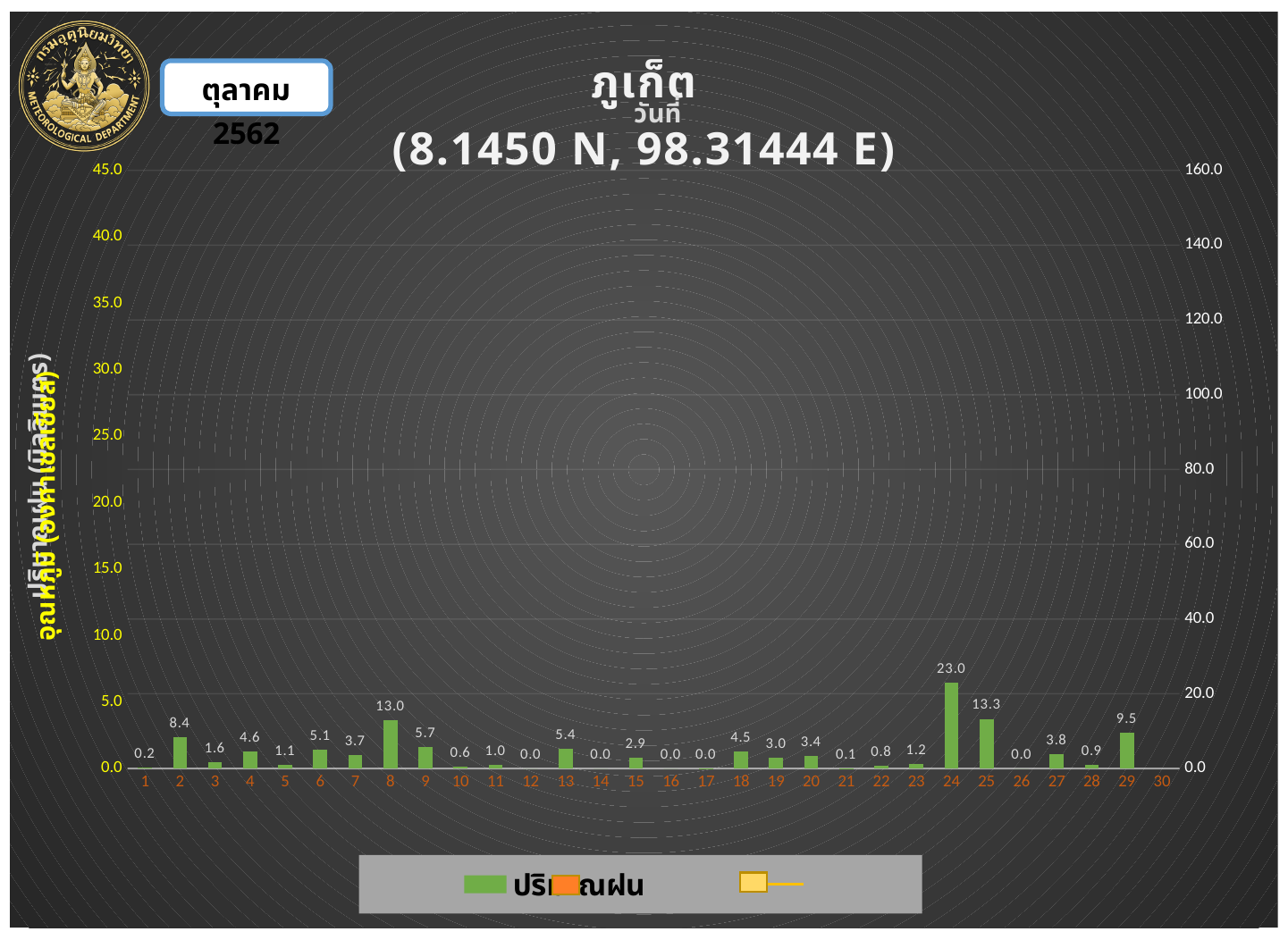
How many days are shown on the x axis? 30 What is the value for day 8? 13.0 What is the difference between the values for day 8 and day 9? 7.3 What is the difference between the values for day 24 and day 25? 9.7 What kind of chart is shown on the slide? bar chart Is the value for day 24 greater or less than 20.0 on the right axis? greater What is the value for day 2? 8.4 Which is larger, the value for day 6 or the value for day 13? day 13 What is the value for day 24? 23.0 Which is larger, the value for day 2 or the value for day 29? day 29 What is the value for day 29? 9.5 Which day has the highest value? 24